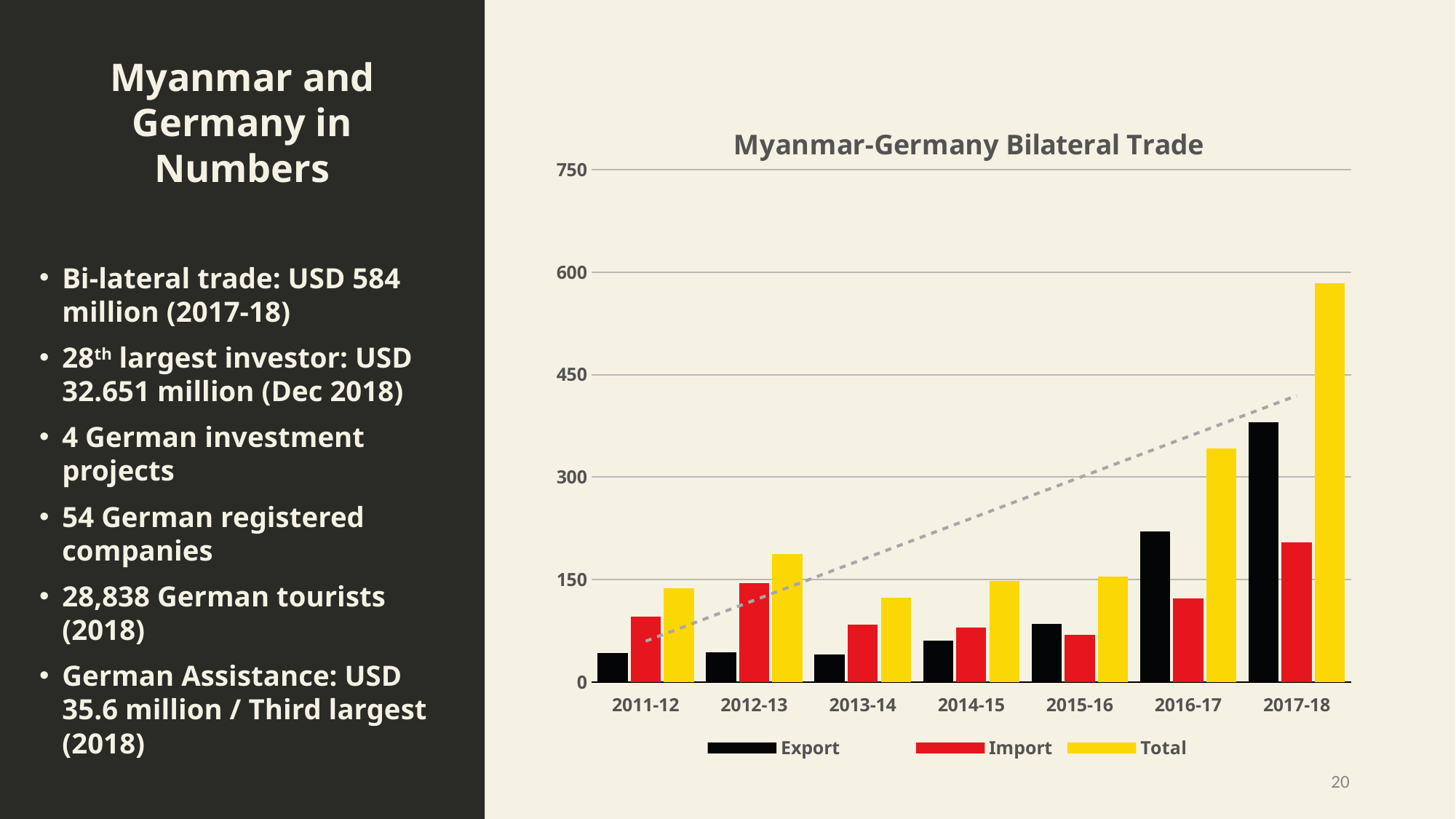
In which year is the Total bar the highest? 2017-18 Is the Total value for 2016-17 greater or less than 300? greater Is the Total value for 2017-18 greater or less than 450? greater In 2011-12, which is larger, Export or Import? Import In which year is the Export bar the highest? 2017-18 What kind of chart is shown on the slide? bar chart What is the title of the chart? Myanmar-Germany Bilateral Trade Is the Export value for 2011-12 greater or less than 150? less Does the dashed trend line rise or fall from 2011-12 to 2017-18? rise How many series does the chart legend list? 3 How many year categories are shown on the x axis of the chart? 7